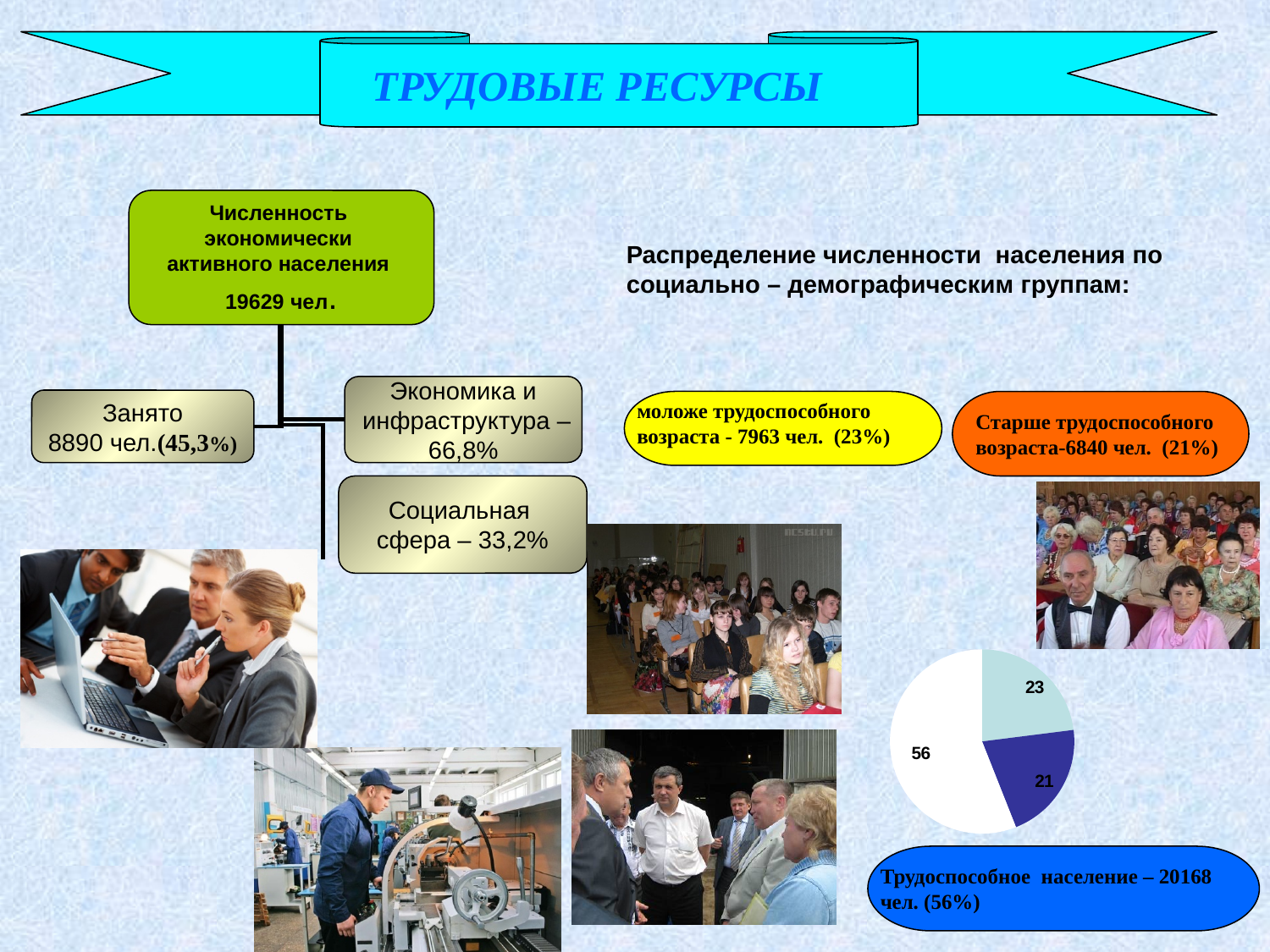
What is the value of the largest slice of the pie chart? 56 Does the pie chart have a legend? No What is the value of the light teal slice of the pie chart? 23 What is the value of the smallest slice of the pie chart? 21 How many slices does the pie chart have? 3 What is the difference between the largest slice (56) and the slice labelled 23 in the pie chart? 33 What is the value of the white slice of the pie chart? 56 What is the difference between the slices labelled 23 and 21 in the pie chart? 2 What is the total of the three slice values shown on the pie chart? 100 What is the value of the dark blue slice of the pie chart? 21 What kind of chart is shown on the slide? pie chart Which slice of the pie chart is larger, the one labelled 23 or the one labelled 21? 23